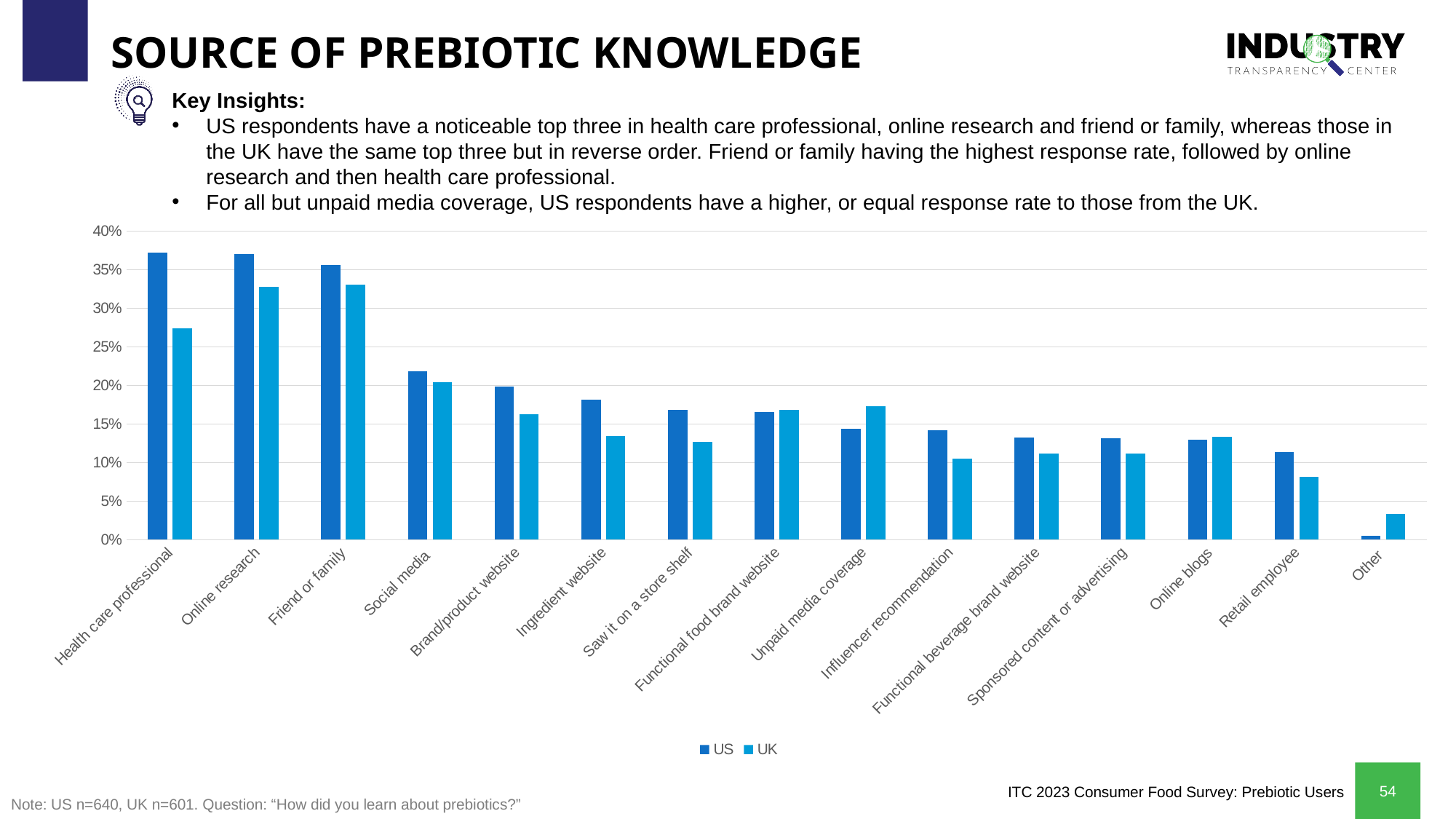
What kind of chart is shown on the slide? bar chart Which category has the lowest value for the UK series? Other Is the UK value for Other greater or less than 5%? less For Health care professional, which series has the larger value, US or UK? US Is the US value for Health care professional greater or less than 35%? greater How many categories are shown on the x axis of the chart? 15 Is the UK value for Retail employee greater or less than 10%? less Do the US values generally rise or fall moving from left to right along the x axis? fall For Unpaid media coverage, which series has the larger value, US or UK? UK How many series does the chart's legend list? 2 Which category has the lowest value for the US series? Other